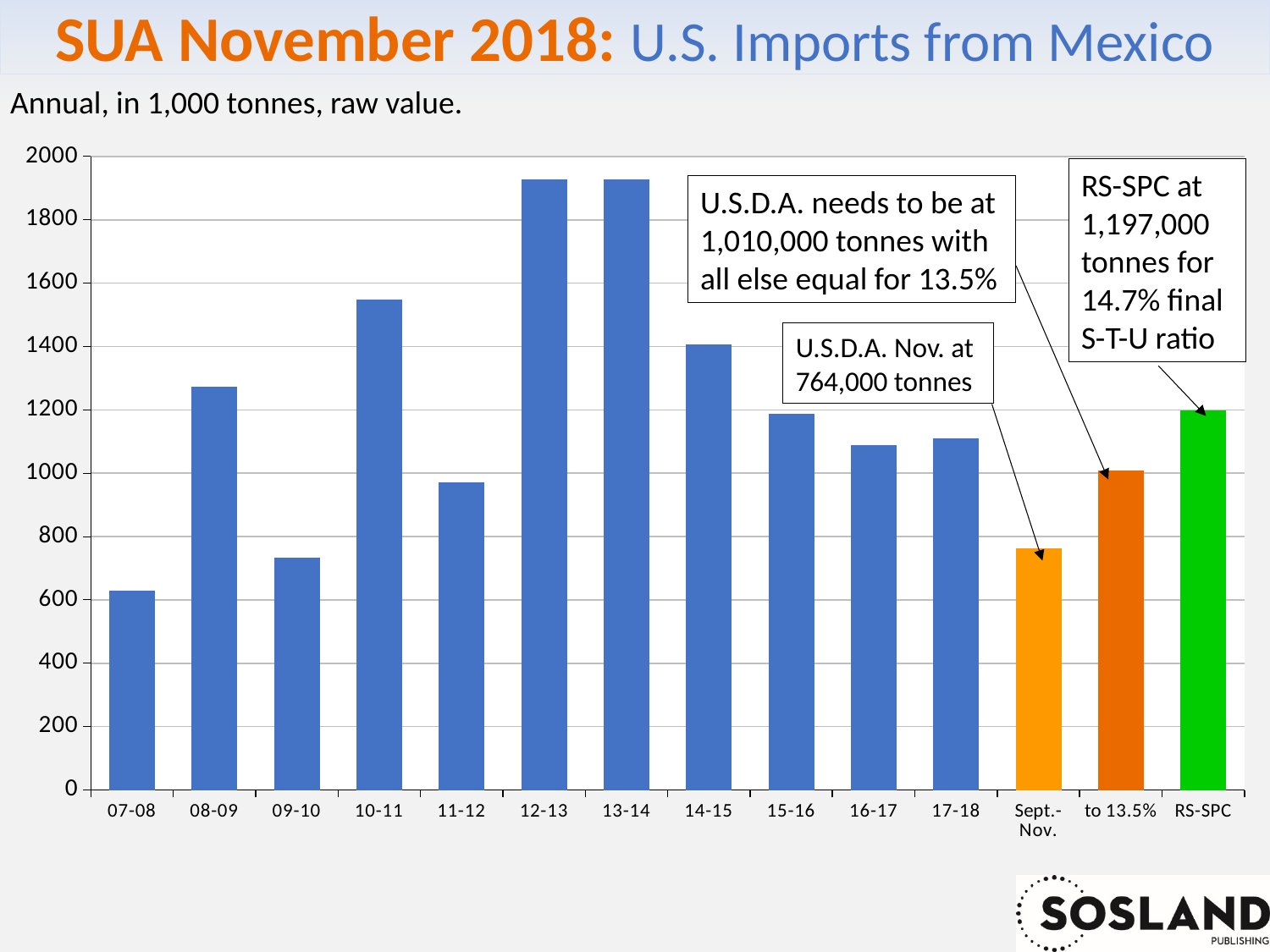
According to the annotation, what is the U.S.D.A. Nov. figure shown for the Sept.-Nov. bar? 764,000 tonnes What colour is the RS-SPC bar? green Is the value for 10-11 greater or less than 1400? greater Which category has the lowest bar in the chart? 07-08 According to the annotation, at what level does U.S.D.A. need to be for a 13.5% ratio? 1,010,000 tonnes How many bars are plotted in the chart? 14 Do the values rise or fall from 14-15 to 16-17? fall Which is larger, the value for 08-09 or the value for 09-10? 08-09 Is the value for 09-10 greater or less than 800? less What kind of chart is shown on the slide? bar chart According to the annotation, what is the RS-SPC figure? 1,197,000 tonnes Is the value for 12-13 greater or less than 1800? greater